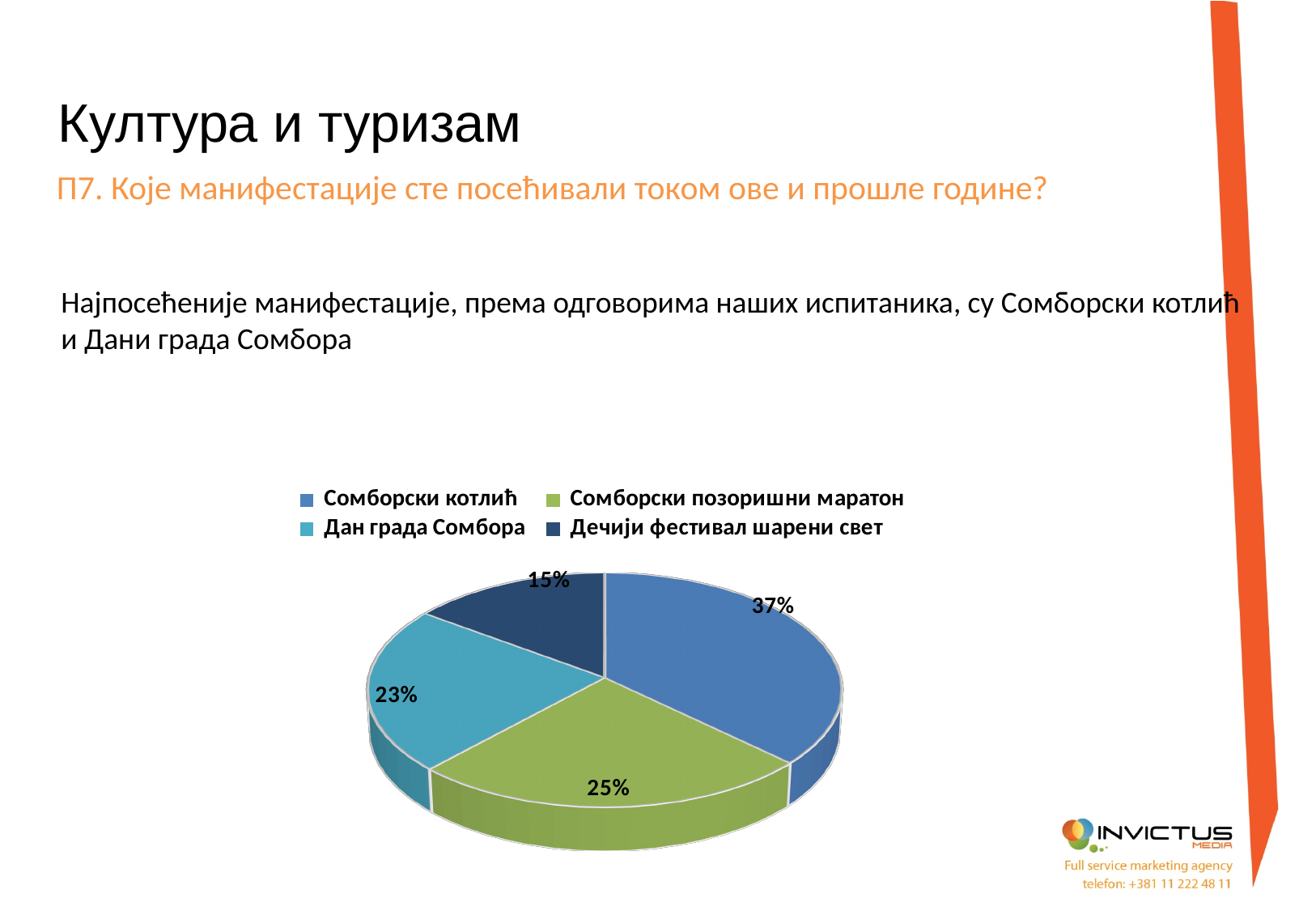
What is the difference in percentage points between Сомборски котлић and Дечији фестивал шарени свет? 22 What share of the pie does Сомборски позоришни маратон have? 25% What is the difference in percentage points between Сомборски позоришни маратон and Дан града Сомбора? 2 What share of the pie does Дан града Сомбора have? 23% Which manifestation has the largest slice of the pie? Сомборски котлић What share of the pie does Сомборски котлић have? 37% Which is larger: the share for Дан града Сомбора or the share for Дечији фестивал шарени свет? Дан града Сомбора Which manifestation is shown in green in the pie chart? Сомборски позоришни маратон What share of the pie does Дечији фестивал шарени свет have? 15% Which manifestation has the smallest slice of the pie? Дечији фестивал шарени свет What kind of chart is shown on the slide? Pie chart How many slices does the pie chart have? 4